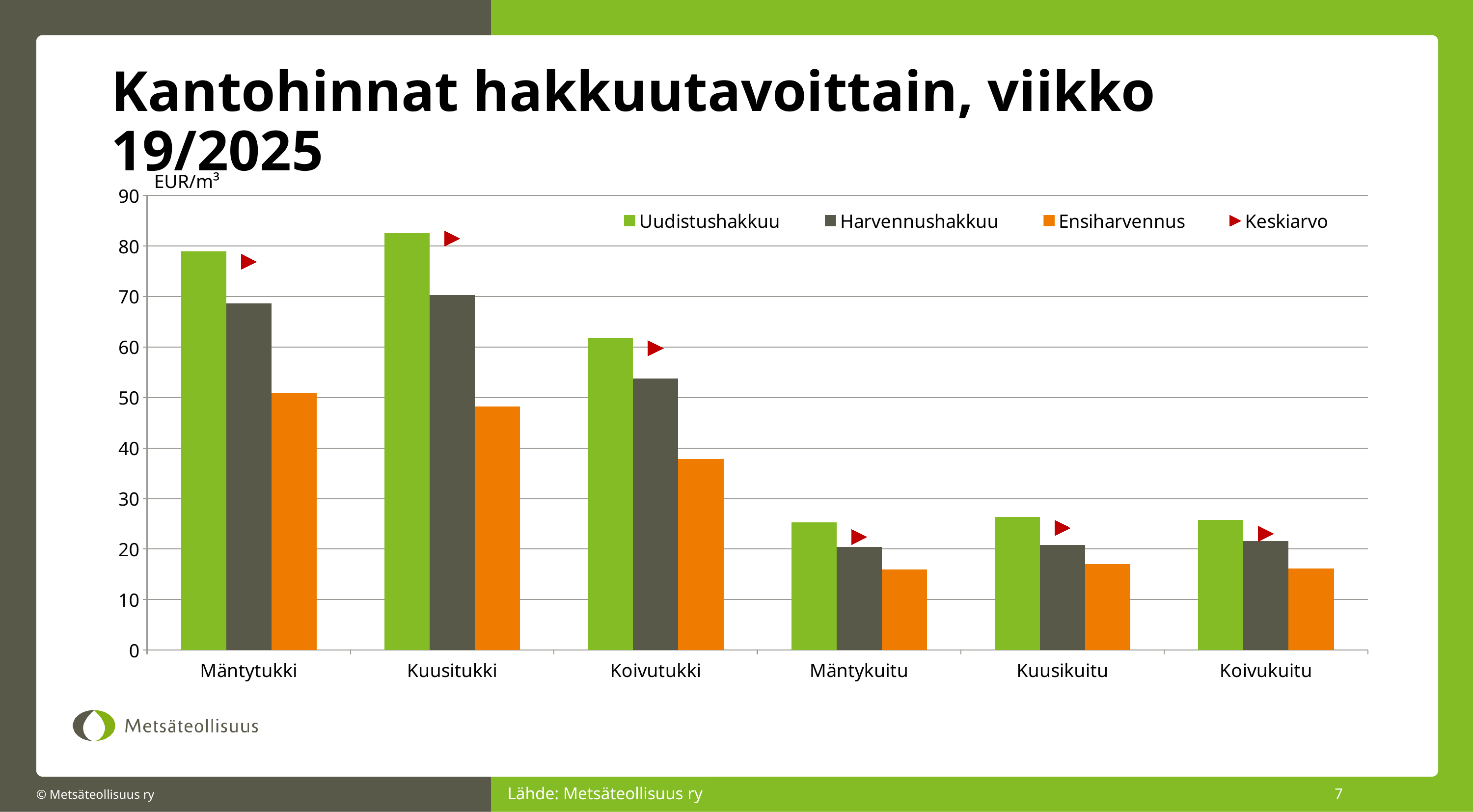
Is the Harvennushakkuu value for Koivutukki greater or less than 50? greater Is the Uudistushakkuu value for Kuusitukki greater or less than 80? greater Is the Ensiharvennus value for Koivutukki greater or less than 40? less Which is larger, the Uudistushakkuu value for Mäntytukki or for Koivutukki? Mäntytukki Which is larger, the Harvennushakkuu value for Kuusitukki or for Koivutukki? Kuusitukki How many categories are shown on the x axis? 6 Which category has the highest Ensiharvennus value? Mäntytukki What kind of chart is shown on the slide? bar chart What unit is shown above the vertical axis? EUR/m³ How many series does the legend list? 4 Which category has the highest Uudistushakkuu value? Kuusitukki